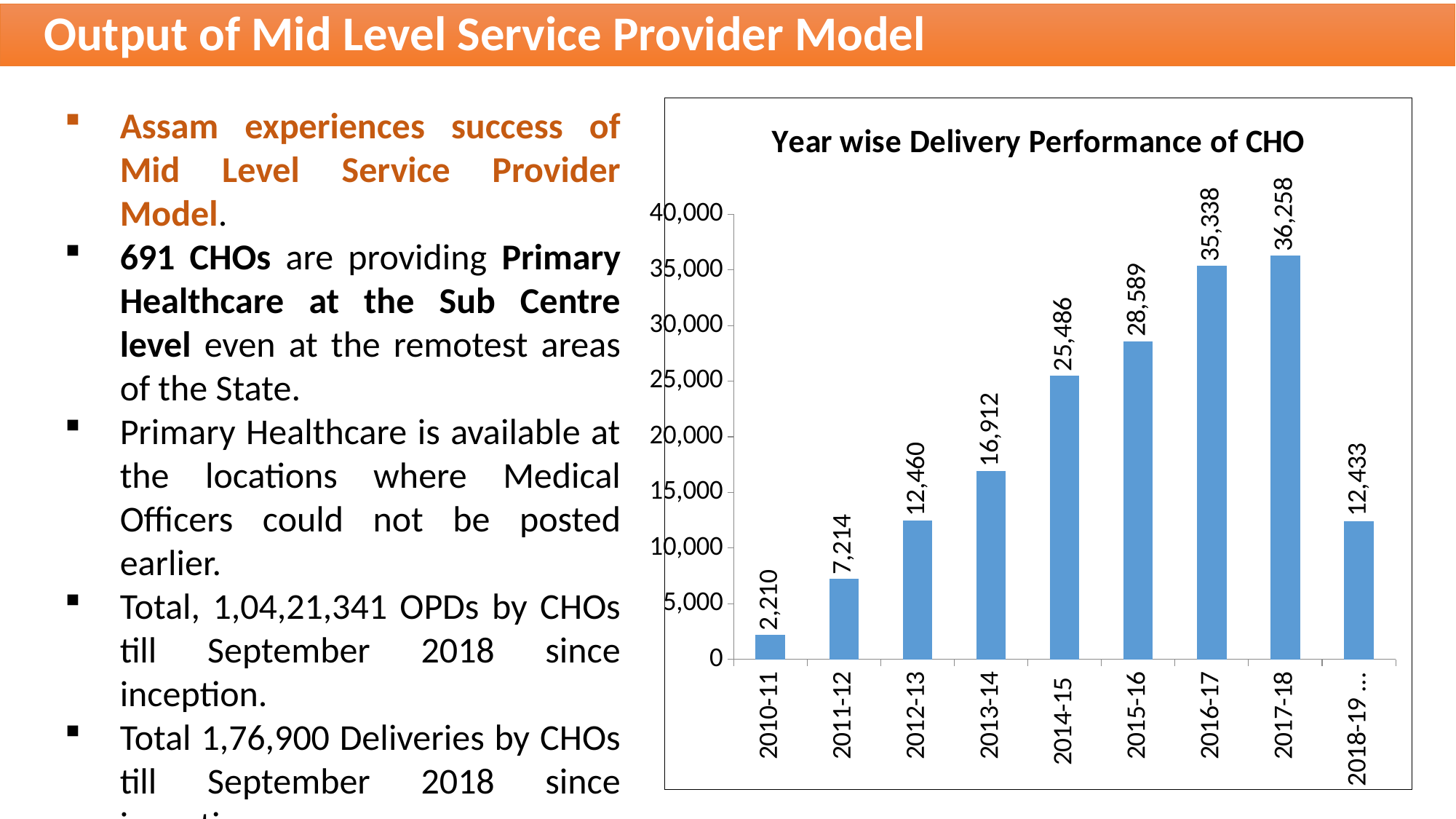
Which year has the highest value in the chart? 2017-18 Which year has the lowest value in the chart? 2010-11 What is the difference between the values for 2015-16 and 2014-15? 3,103 What kind of chart is shown on the slide? bar chart What is the value for 2010-11 in the chart? 2,210 Which is larger, the value for 2012-13 or the value for 2018-19? 2012-13 What is the difference between the values for 2017-18 and 2016-17? 920 How many years are shown on the x axis of the chart? 9 What is the value shown for 2018-19 in the chart? 12,433 Do the values rise or fall from 2010-11 to 2017-18? rise What is the value for 2014-15 in the Year wise Delivery Performance of CHO chart? 25,486 Is the value for 2013-14 greater or less than 15,000? greater